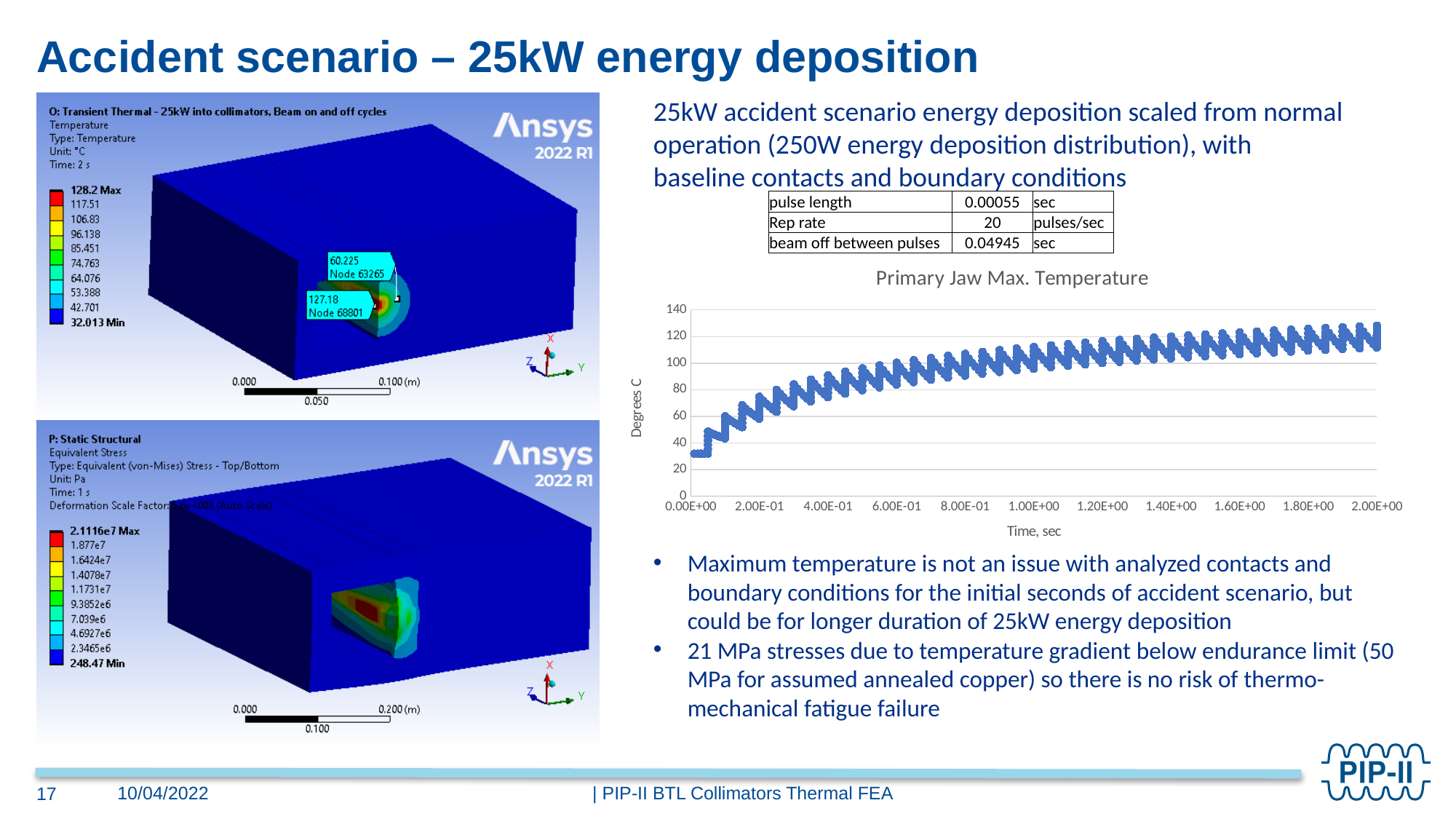
In the Primary Jaw Max. Temperature chart, is the temperature higher at time 2.00E+00 or at time 4.00E-01? 2.00E+00 What is the title of the chart on the slide? Primary Jaw Max. Temperature In the Primary Jaw Max. Temperature chart, is the temperature at time 1.00E+00 greater or less than 80? greater In the Primary Jaw Max. Temperature chart, is the temperature at time 2.00E+00 greater or less than 140? less What kind of chart is the Primary Jaw Max. Temperature chart? scatter chart In the Primary Jaw Max. Temperature chart, is the temperature at time 0.00E+00 greater or less than 40? less What is the highest value shown on the vertical axis of the Primary Jaw Max. Temperature chart? 140 What is the label of the vertical axis in the Primary Jaw Max. Temperature chart? Degrees C In the Primary Jaw Max. Temperature chart, does the temperature generally rise or fall as time increases? rise